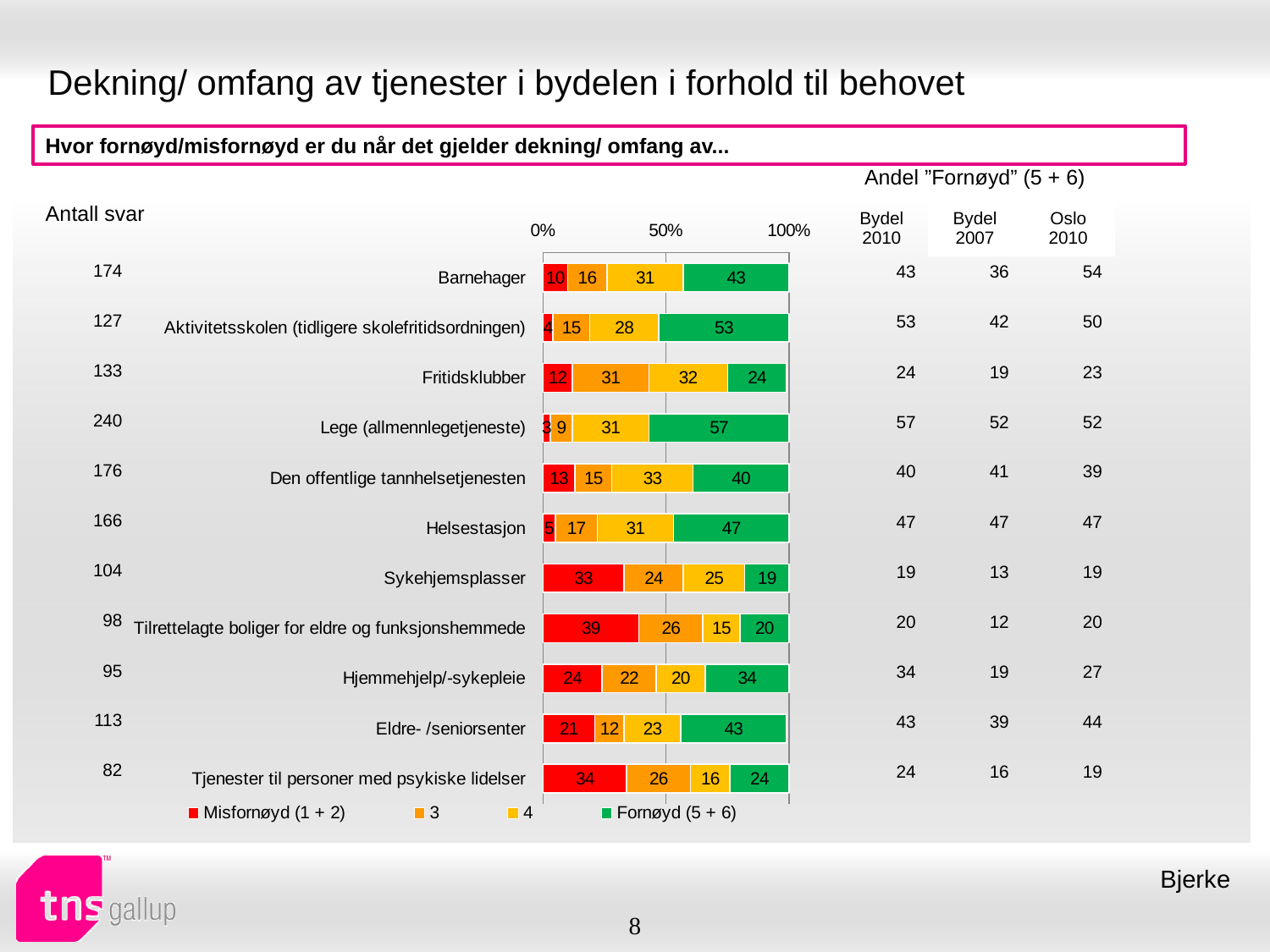
What is the Fornøyd (5 + 6) value for Lege (allmennlegetjeneste)? 57 Which category has the highest Misfornøyd (1 + 2) value? Tilrettelagte boliger for eldre og funksjonshemmede How many series does the chart legend list? 4 Which category has the highest Fornøyd (5 + 6) value? Lege (allmennlegetjeneste) What is the difference between the Fornøyd (5 + 6) values for Barnehager and Fritidsklubber? 19 What kind of chart is shown on the slide? Stacked bar chart How many service categories are plotted in the chart? 11 Which category has the lowest Fornøyd (5 + 6) value? Sykehjemsplasser Which has the larger Fornøyd (5 + 6) value, Helsestasjon or Den offentlige tannhelsetjenesten? Helsestasjon What is the first entry in the chart legend? Misfornøyd (1 + 2) What is the value of the '3' series for Fritidsklubber? 31 What is the Misfornøyd (1 + 2) value for Sykehjemsplasser? 33